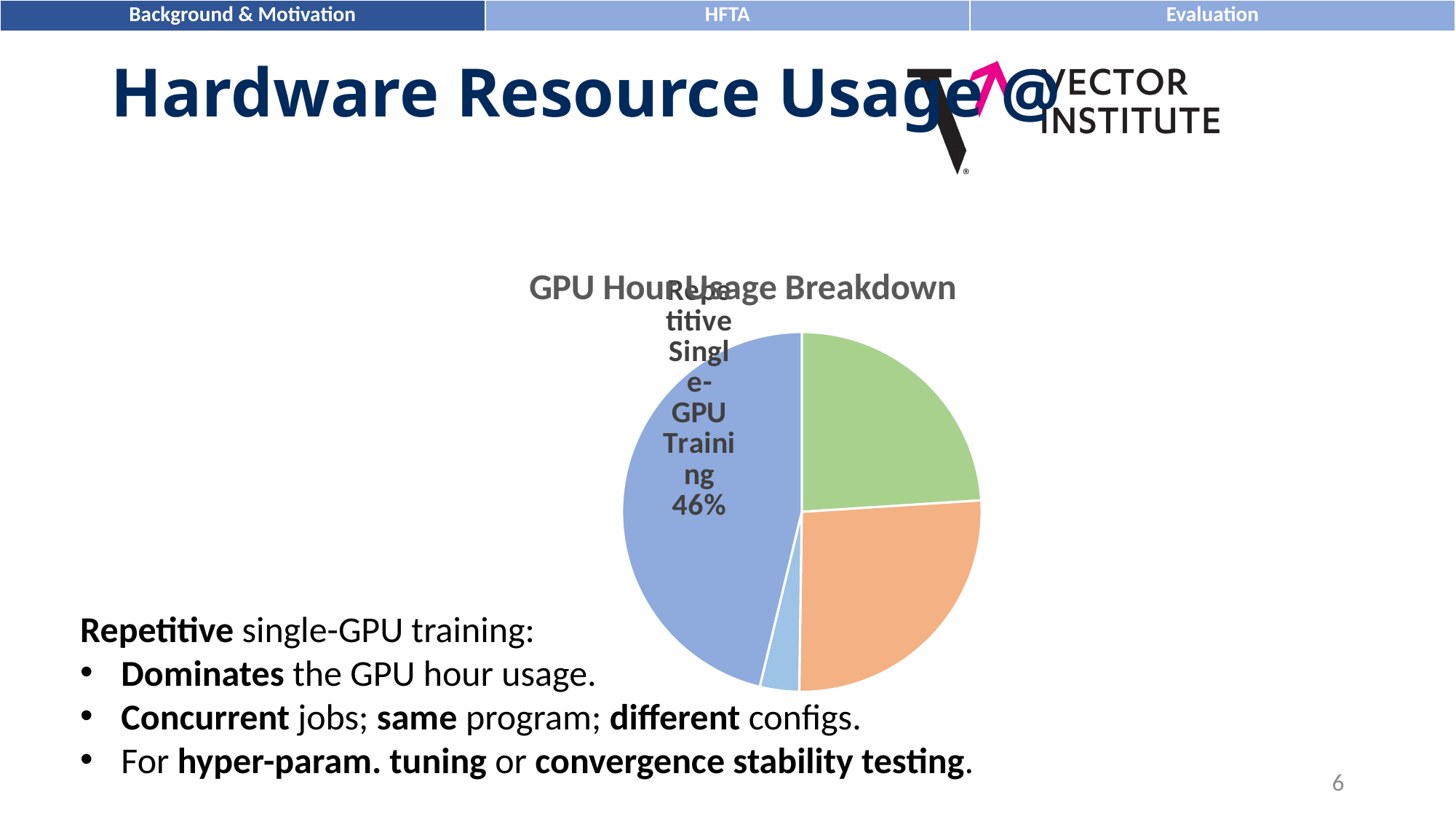
What colour is the Repetitive Single-GPU Training slice in the pie chart? blue Is the share for Repetitive Single-GPU Training greater or less than 50%? less What kind of chart is shown on the slide? pie chart What share of GPU hours does Repetitive Single-GPU Training account for in the pie chart? 46% What is the title of the chart? GPU Hour Usage Breakdown How many slices does the pie chart have? 4 Which slice of the pie chart is the largest? Repetitive Single-GPU Training Is the share for Repetitive Single-GPU Training greater or less than 25%? greater